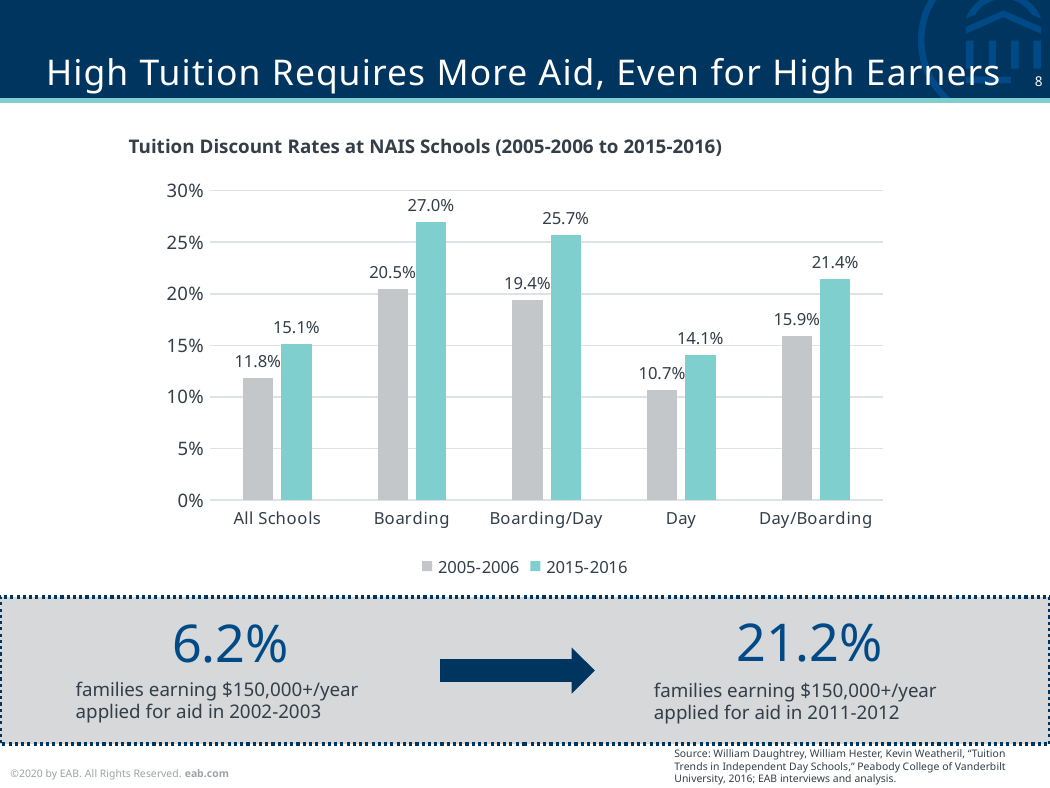
Which category has the lowest tuition discount rate in 2005-2006? Day How many series does the chart legend list? 2 What is the tuition discount rate for Day schools in 2015-2016? 14.1% What is the difference between the 2015-2016 and 2005-2006 tuition discount rates for Day/Boarding schools? 5.5% Which is larger: the 2015-2016 rate for Boarding/Day schools or the 2015-2016 rate for Day/Boarding schools? Boarding/Day What is the tuition discount rate for Boarding schools in 2015-2016? 27.0% What type of chart is used to show the tuition discount rates? Bar chart What is the title of the chart on the slide? Tuition Discount Rates at NAIS Schools (2005-2006 to 2015-2016) How many school categories are shown on the x axis of the chart? 5 What is the tuition discount rate for All Schools in 2005-2006? 11.8% Is the 2005-2006 tuition discount rate for Boarding schools greater or less than 20%? greater Which category has the highest tuition discount rate in 2015-2016? Boarding